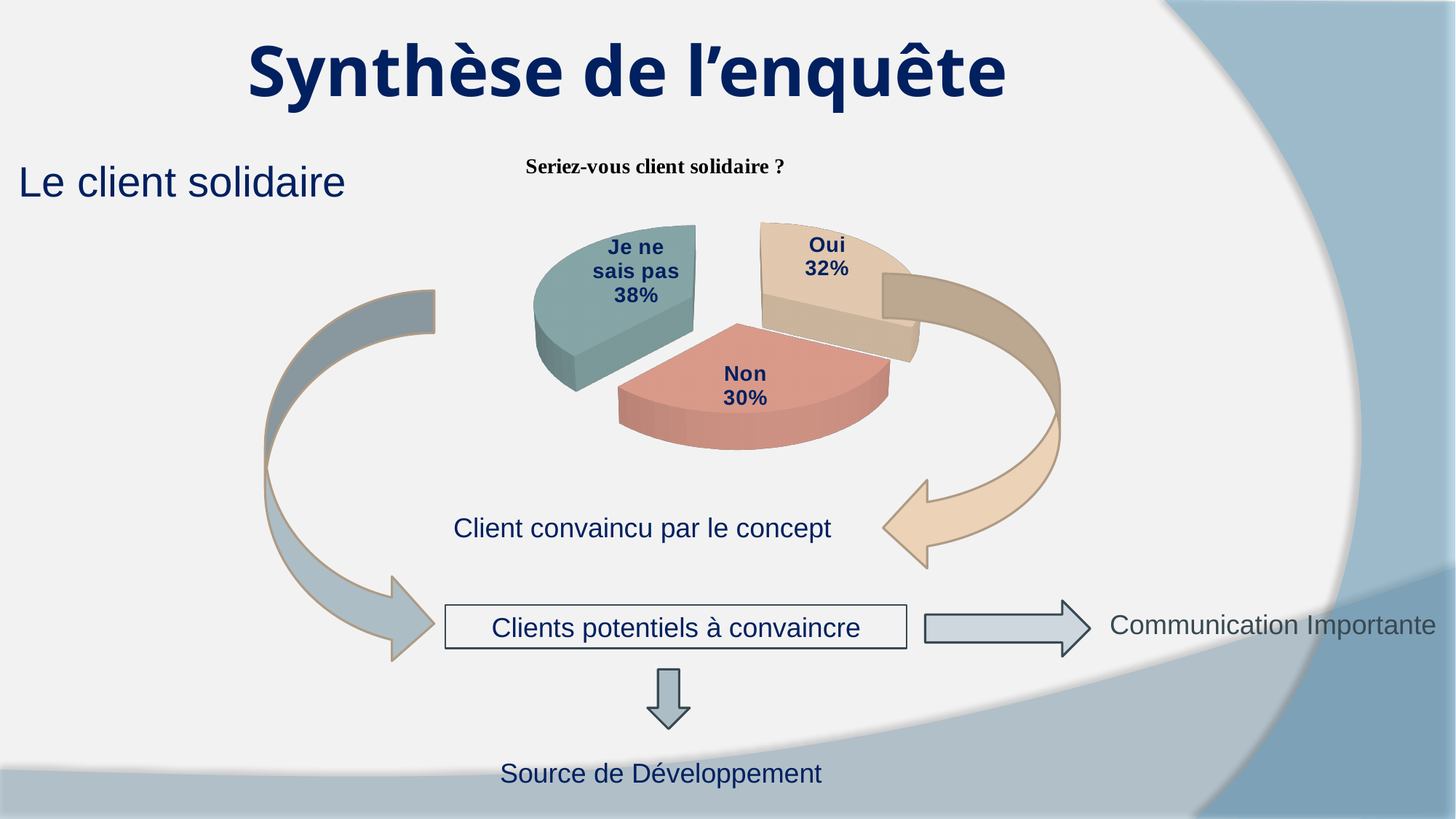
What percentage of respondents answered "Non"? 30% What is the difference in percentage points between "Oui" and "Non"? 2 What percentage of respondents answered "Oui"? 32% What is the title of the pie chart? Seriez-vous client solidaire ? How many slices does the pie chart have? 3 Which response has the smallest share of the pie? Non What kind of chart is shown on the slide? pie chart What is the difference in percentage points between "Je ne sais pas" and "Oui"? 6 Which is larger, the share for "Oui" or the share for "Non"? Oui What percentage of respondents answered "Je ne sais pas"? 38% What colour is the "Non" slice of the pie chart? red Which response has the largest share of the pie? Je ne sais pas